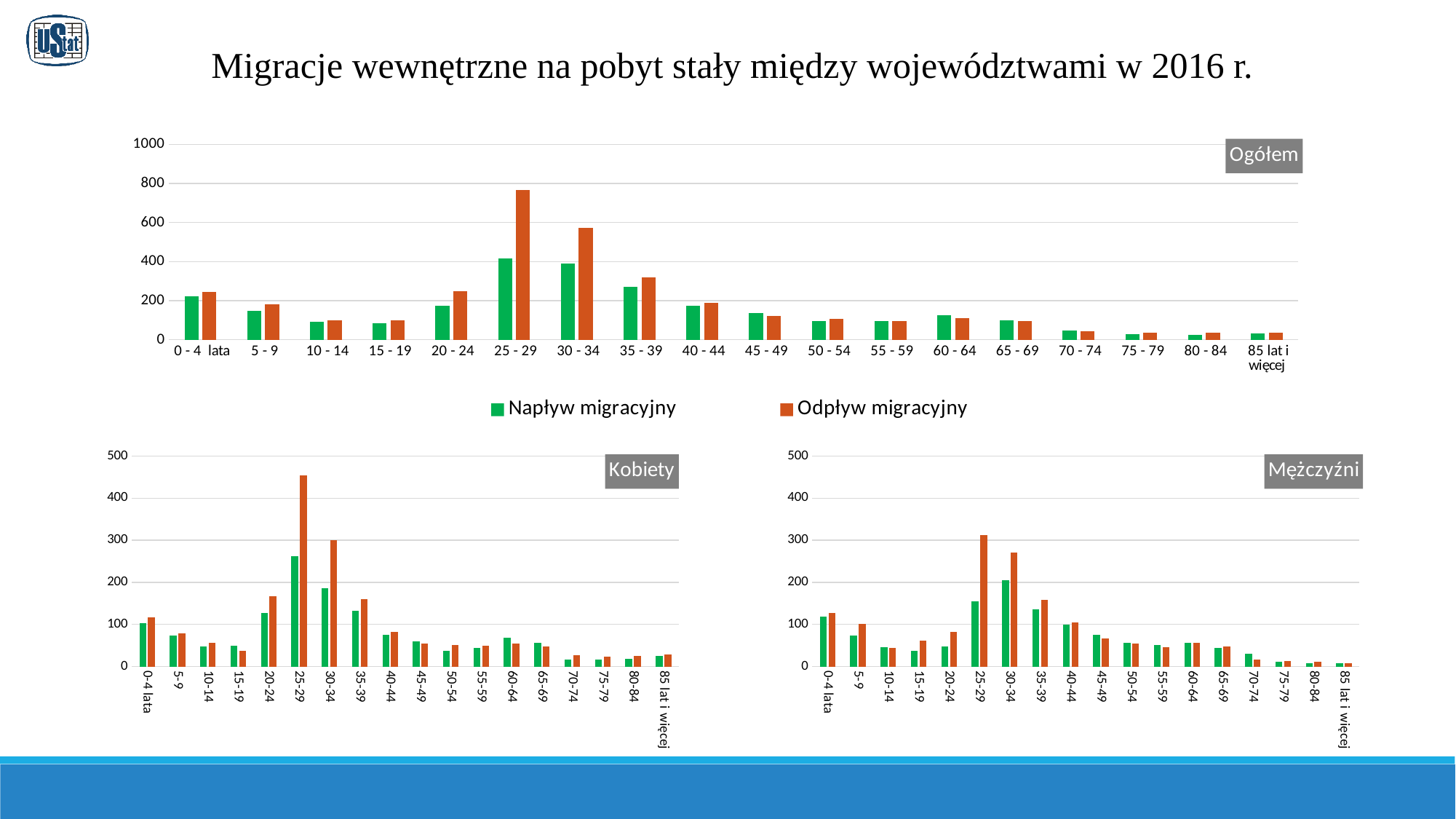
In the Kobiety chart, which age category has the highest Odpływ migracyjny value? 25-29 In the Ogółem chart, which age category has the highest Odpływ migracyjny value? 25 - 29 In the Kobiety chart, is the Odpływ migracyjny value for 25-29 greater or less than 400? greater What kind of chart is the Ogółem chart at the top of the slide? bar chart Which colour represents Odpływ migracyjny in the charts? orange In the Mężczyźni chart, which age category has the highest Napływ migracyjny value? 30-34 In the Ogółem chart, which is larger for 20 - 24: Napływ migracyjny or Odpływ migracyjny? Odpływ migracyjny How many age categories are shown on the x axis of the Ogółem chart? 18 In the Ogółem chart, is the Napływ migracyjny value for 25 - 29 greater or less than 600? less In the Ogółem chart, is the Odpływ migracyjny value for 25 - 29 greater or less than 600? greater In the Ogółem chart, do the Odpływ migracyjny values rise or fall from 25 - 29 to 45 - 49? fall How many series does the legend list for the charts on the slide? 2